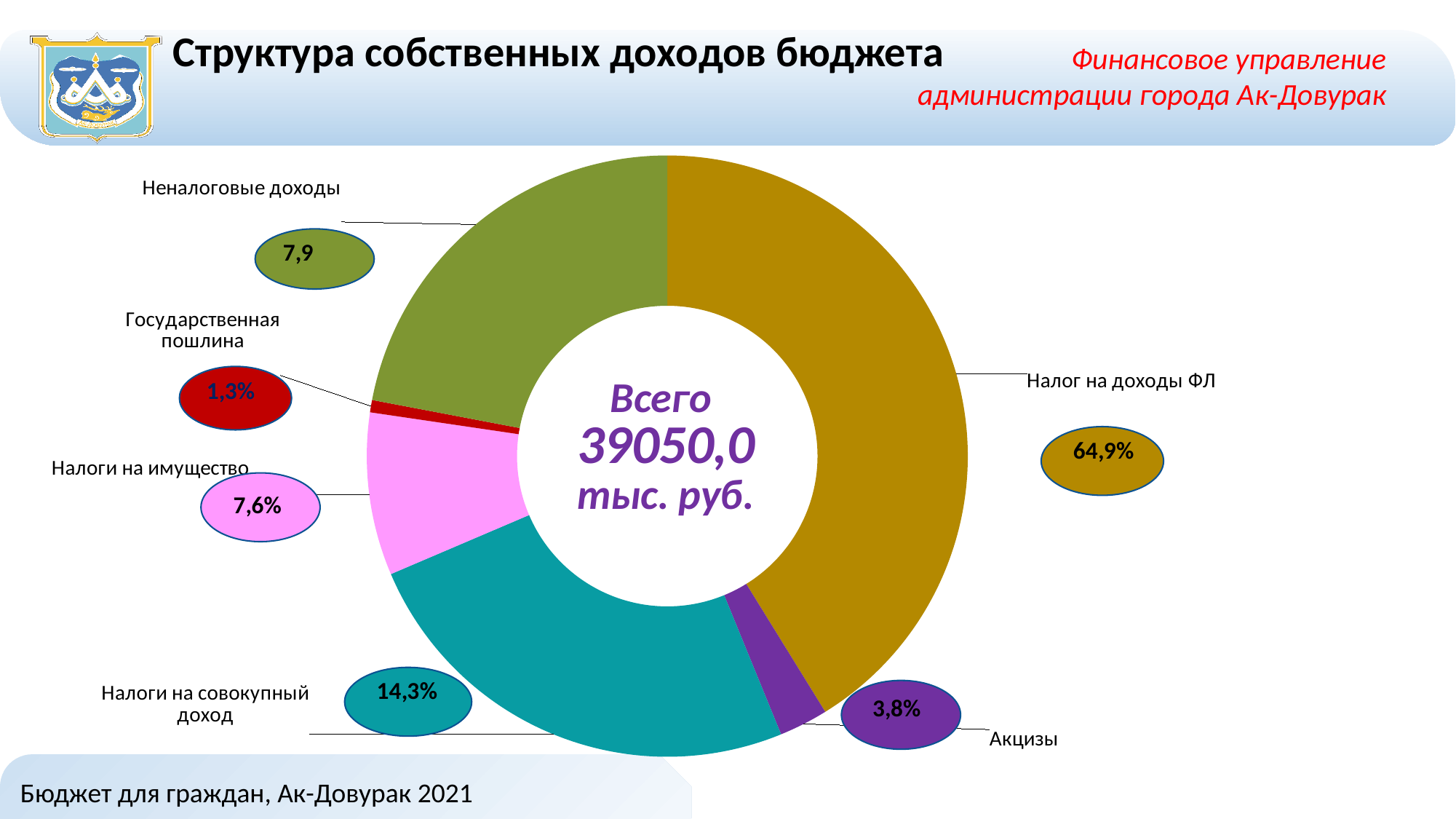
What kind of chart is shown on the slide? pie chart (donut) What is the share for Налоги на имущество? 7,6% What value is shown for Неналоговые доходы? 7,9 Which category has the largest share of the chart? Налог на доходы ФЛ Which is larger, the share for Акцизы or the share for Государственная пошлина? Акцизы What total amount is shown in the centre of the chart? 39050,0 тыс. руб. What is the share for Акцизы? 3,8% How many categories does the chart show? 6 What is the share for Налоги на совокупный доход? 14,3% Which category has the smallest share of the chart? Государственная пошлина What is the share for Налог на доходы ФЛ? 64,9% What is the difference in percentage points between Налог на доходы ФЛ and Налоги на совокупный доход? 50,6